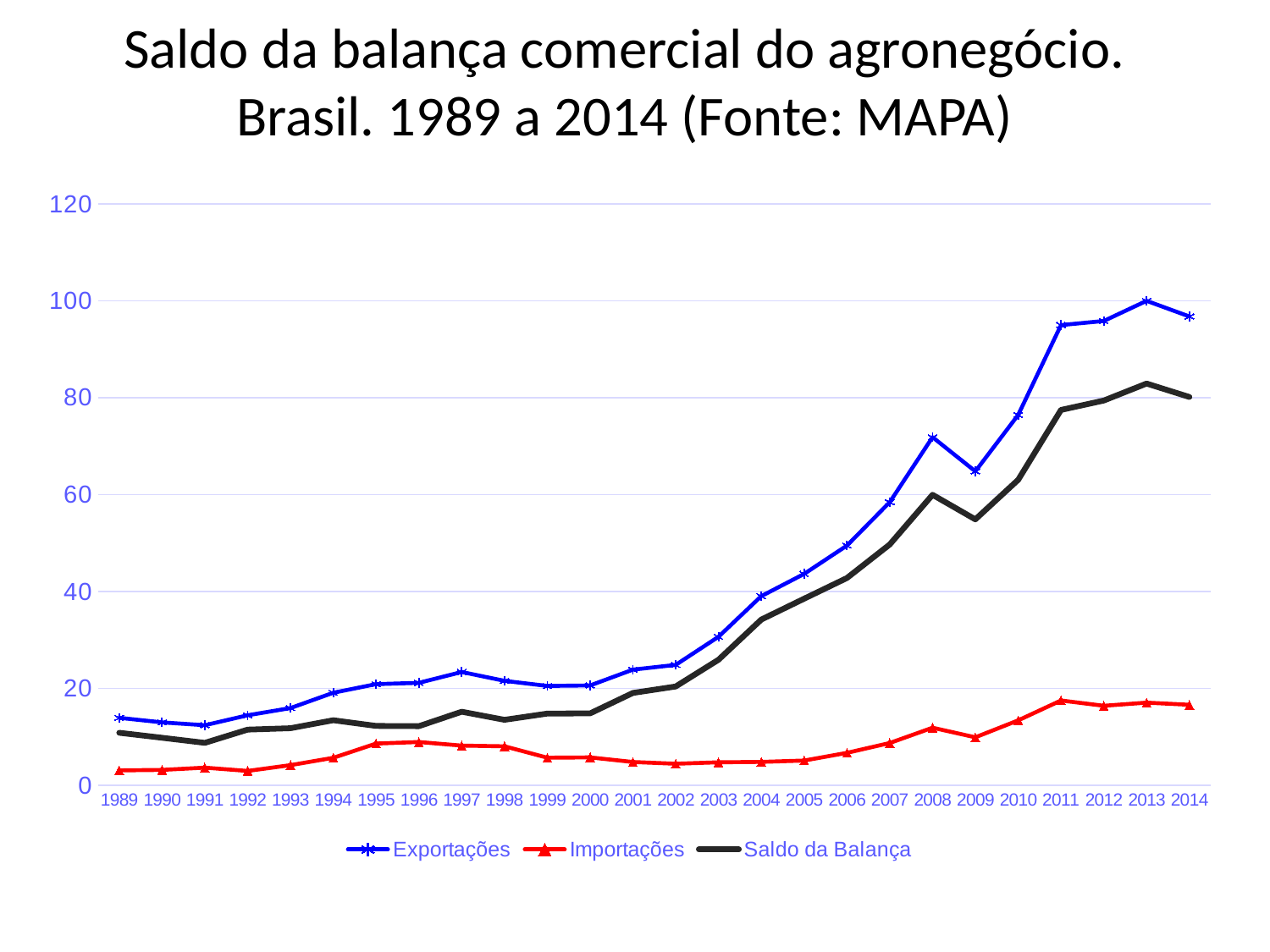
In which year is the Saldo da Balança series at its lowest? 1991 Is the value for Saldo da Balança in 2009 greater or less than 60? less Which is larger, Saldo da Balança in 2008 or Saldo da Balança in 2009? 2008 What kind of chart is shown on the slide? line chart Is the value for Importações in 2011 greater or less than 20? less In which year is the Exportações series at its highest? 2013 How many years are plotted along the x axis? 26 Is the value for Exportações in 2008 greater or less than 60? greater Which is larger, Exportações in 2008 or Exportações in 2009? 2008 What are the three series named in the legend? Exportações, Importações, Saldo da Balança How many series does the legend list? 3 Do the Exportações values rise or fall from 2009 to 2013? rise